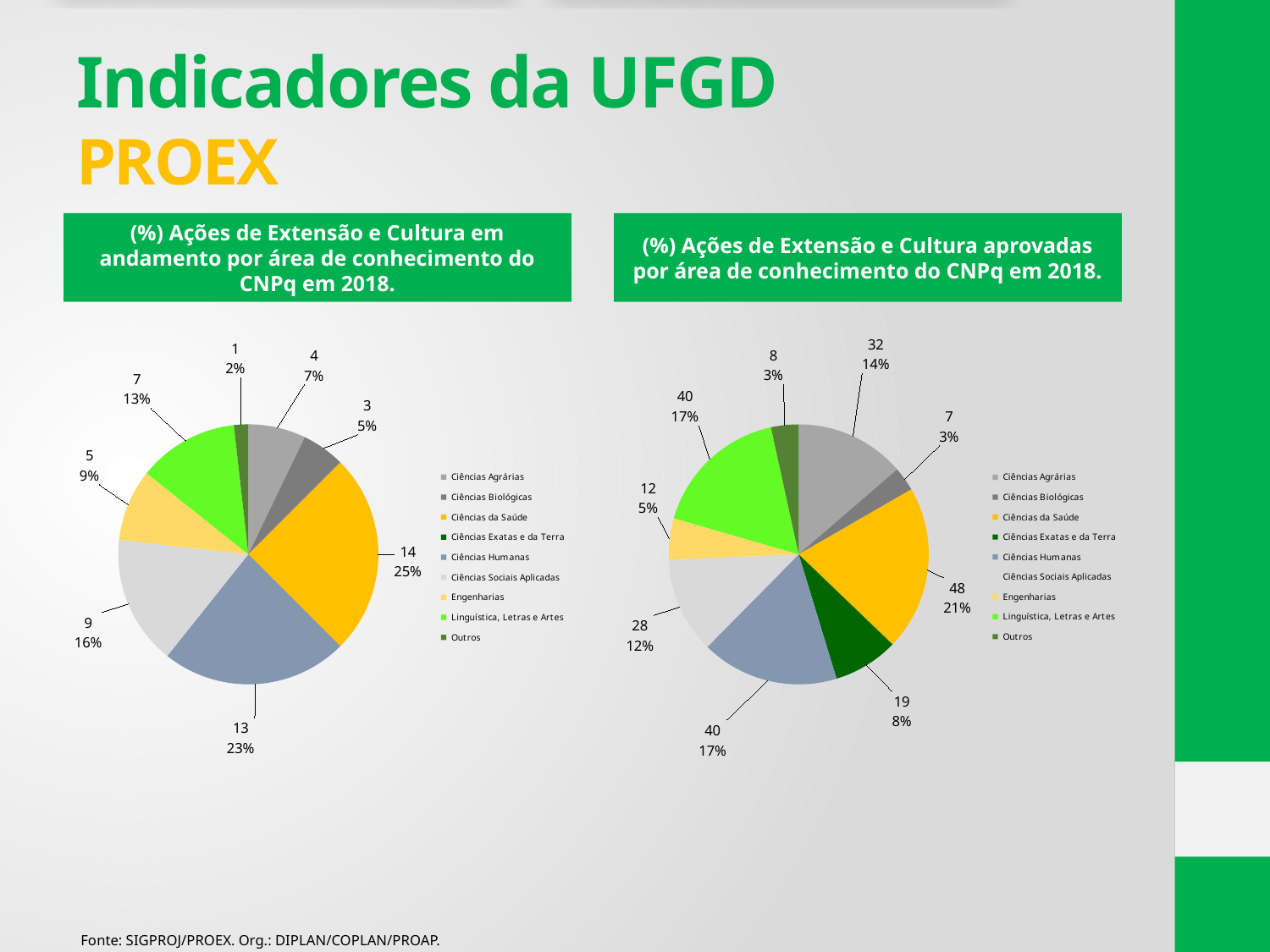
In the right chart (ações aprovadas), which area has the largest share? Ciências da Saúde How many entries does the legend of the right chart (ações aprovadas) list? 9 In the right chart (ações aprovadas), what count is shown for Ciências Humanas? 40 In the left chart (ações em andamento), what percentage share does Ciências da Saúde have? 25% In the left chart (ações em andamento), what is the count shown for Engenharias? 5 In the right chart (ações aprovadas), which is larger: the share for Ciências Agrárias or for Ciências Sociais Aplicadas? Ciências Agrárias In the left chart (ações em andamento), what is the difference between the counts for Ciências da Saúde and Ciências Humanas? 1 In the right chart (ações aprovadas), what percentage share does Ciências Exatas e da Terra have? 8% In the left chart (ações em andamento), which area has the largest slice? Ciências da Saúde What kind of chart is the left chart, '(%) Ações de Extensão e Cultura em andamento por área de conhecimento do CNPq em 2018'? Pie chart In the left chart (ações em andamento), which area has the smallest slice? Outros In the right chart (ações aprovadas), what is the difference between the counts for Ciências da Saúde and Ciências Exatas e da Terra? 29